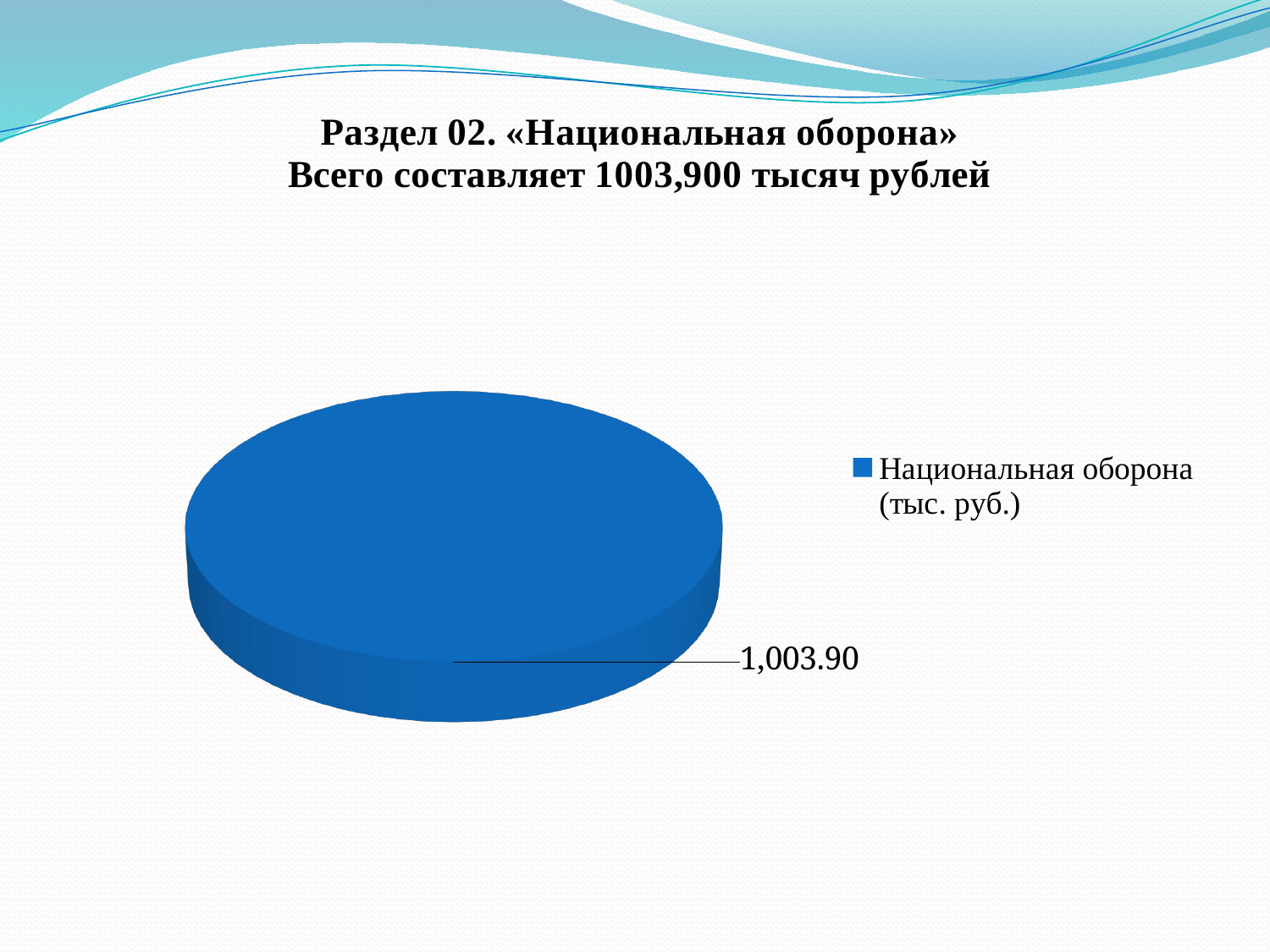
What is the value for Национальная оборона (тыс. руб.) on the pie chart? 1,003.90 What colour is the slice in the pie chart? blue How many slices does the pie chart have? 1 How many entries does the legend of the pie chart list? 1 What share of the pie does the Национальная оборона slice take up? 100% What is the legend entry of the pie chart? Национальная оборона (тыс. руб.) What kind of chart is shown on the slide? pie chart What value is shown by the data label on the pie chart? 1,003.90